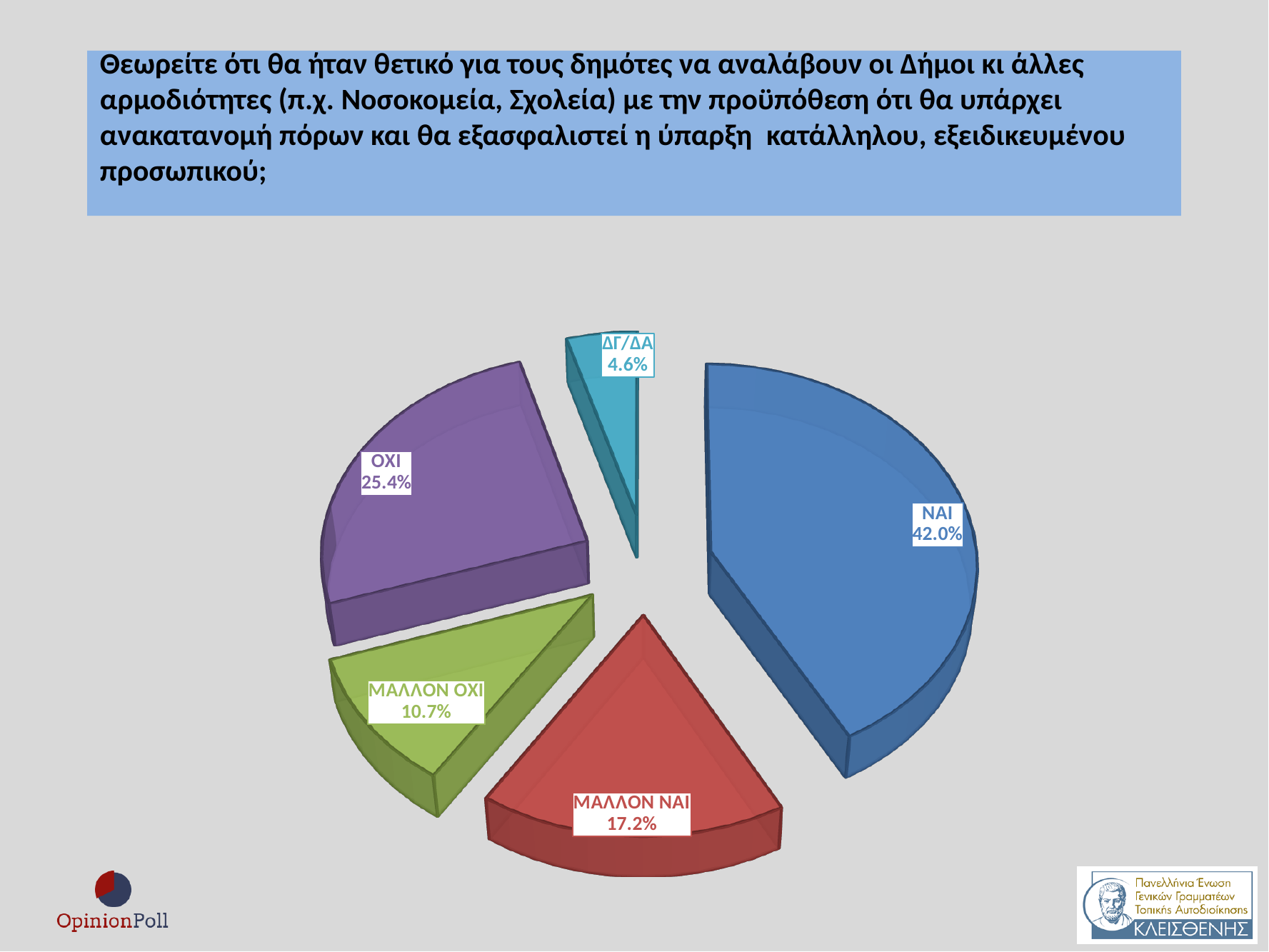
Which response has the largest share of the pie? ΝΑΙ Which response has the smallest share of the pie? ΔΓ/ΔΑ What is the value shown for ΜΑΛΛΟΝ ΝΑΙ? 17.2% Which is larger, the share for ΜΑΛΛΟΝ ΝΑΙ or the share for ΜΑΛΛΟΝ ΟΧΙ? ΜΑΛΛΟΝ ΝΑΙ What percentage of respondents answered ΝΑΙ? 42.0% What kind of chart is shown on the slide? Pie chart What is the value shown for ΔΓ/ΔΑ? 4.6% What colour is the ΟΧΙ slice? Purple What is the difference in percentage points between ΝΑΙ and ΟΧΙ? 16.6 What is the value shown for ΜΑΛΛΟΝ ΟΧΙ? 10.7% What percentage of respondents answered ΟΧΙ? 25.4% How many slices does the pie chart have? 5